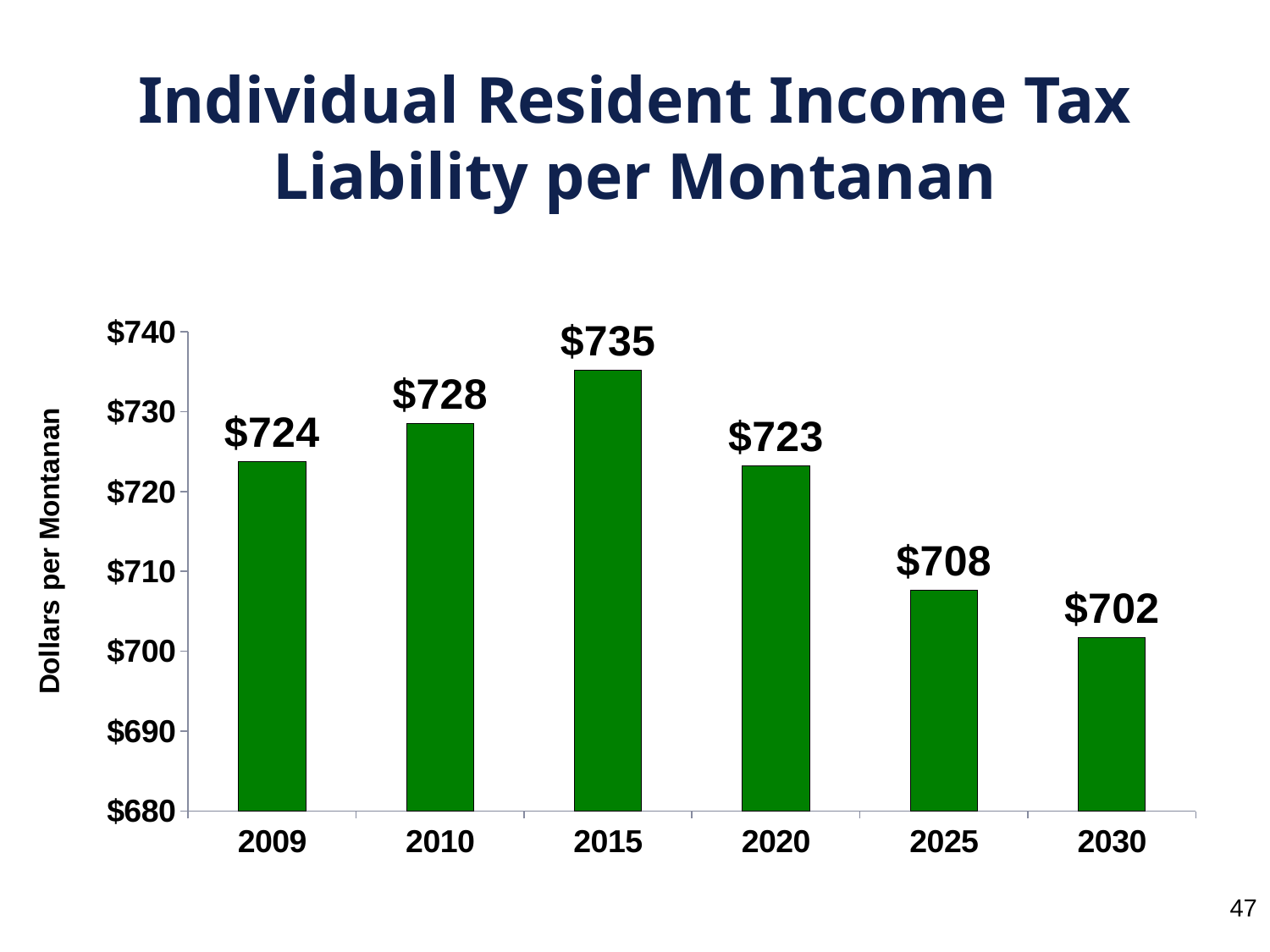
Is the value for 2025 greater or less than $710? less What is the label on the vertical axis? Dollars per Montanan Which is larger, the value for 2020 or the value for 2025? 2020 Which year has the lowest tax liability per Montanan? 2030 How many years are shown on the x axis? 6 What is the difference between the 2010 value and the 2025 value? $20 What is the difference between the 2015 value and the 2030 value? $33 What kind of chart is shown on the slide? bar chart What is the value shown for 2030? $702 What is the individual resident income tax liability per Montanan in 2015? $735 What is the value shown for 2009? $724 Which year has the highest tax liability per Montanan? 2015